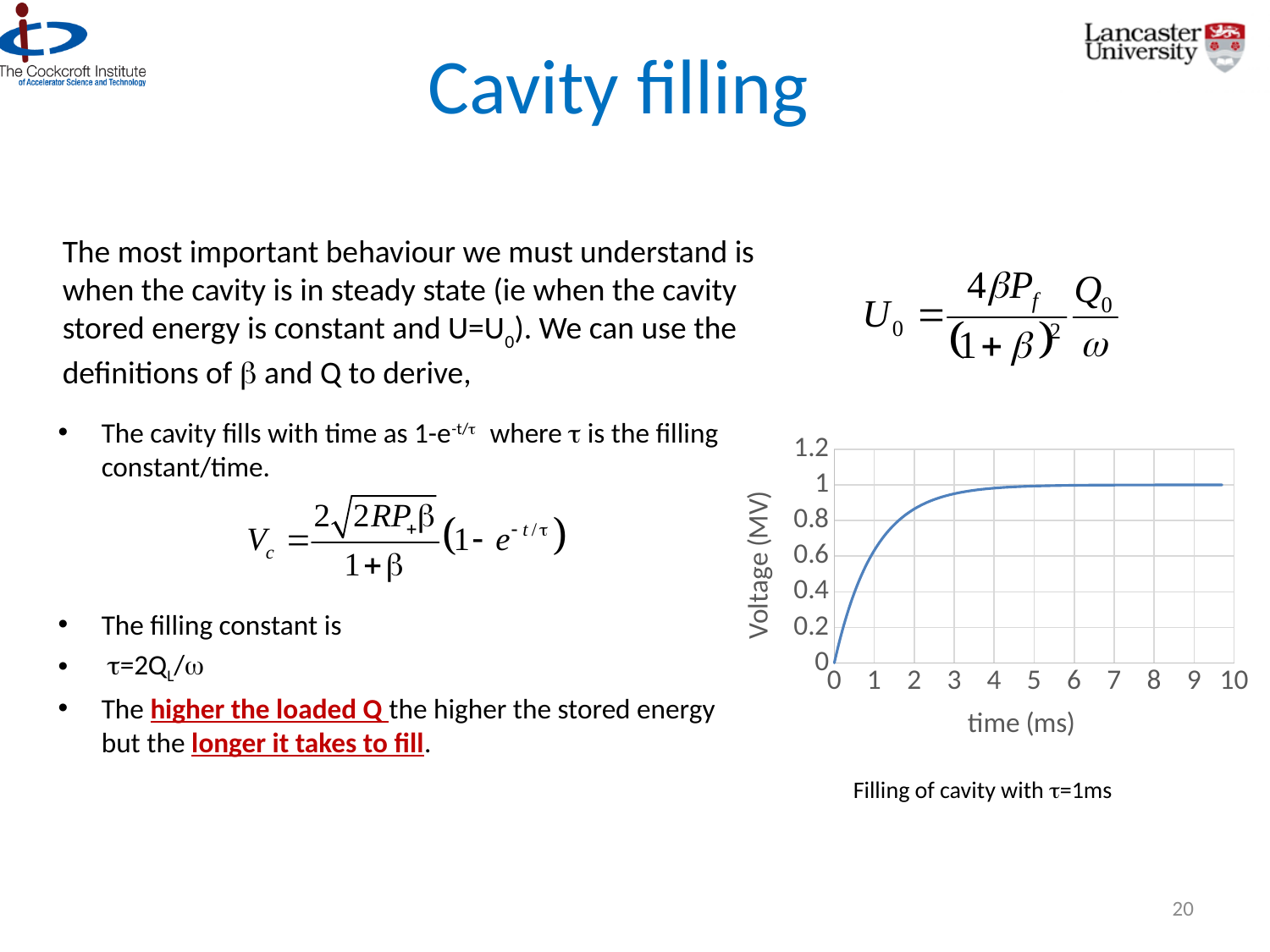
At what voltage (MV) does the curve level off? 1 Is the voltage at 8 ms greater or less than 1.2? less What is the label of the y axis? Voltage (MV) Does the voltage rise or fall as time increases along the x axis? rise What is the voltage at time 0 ms? 0 Is the voltage at 0.5 ms greater or less than 0.6? less At which time shown on the x axis is the voltage lowest? 0 Is the voltage at 5 ms greater or less than 0.8? greater Is the voltage at 4 ms larger or smaller than the voltage at 1 ms? larger What kind of chart is shown on the slide? line chart What is the label of the x axis? time (ms)